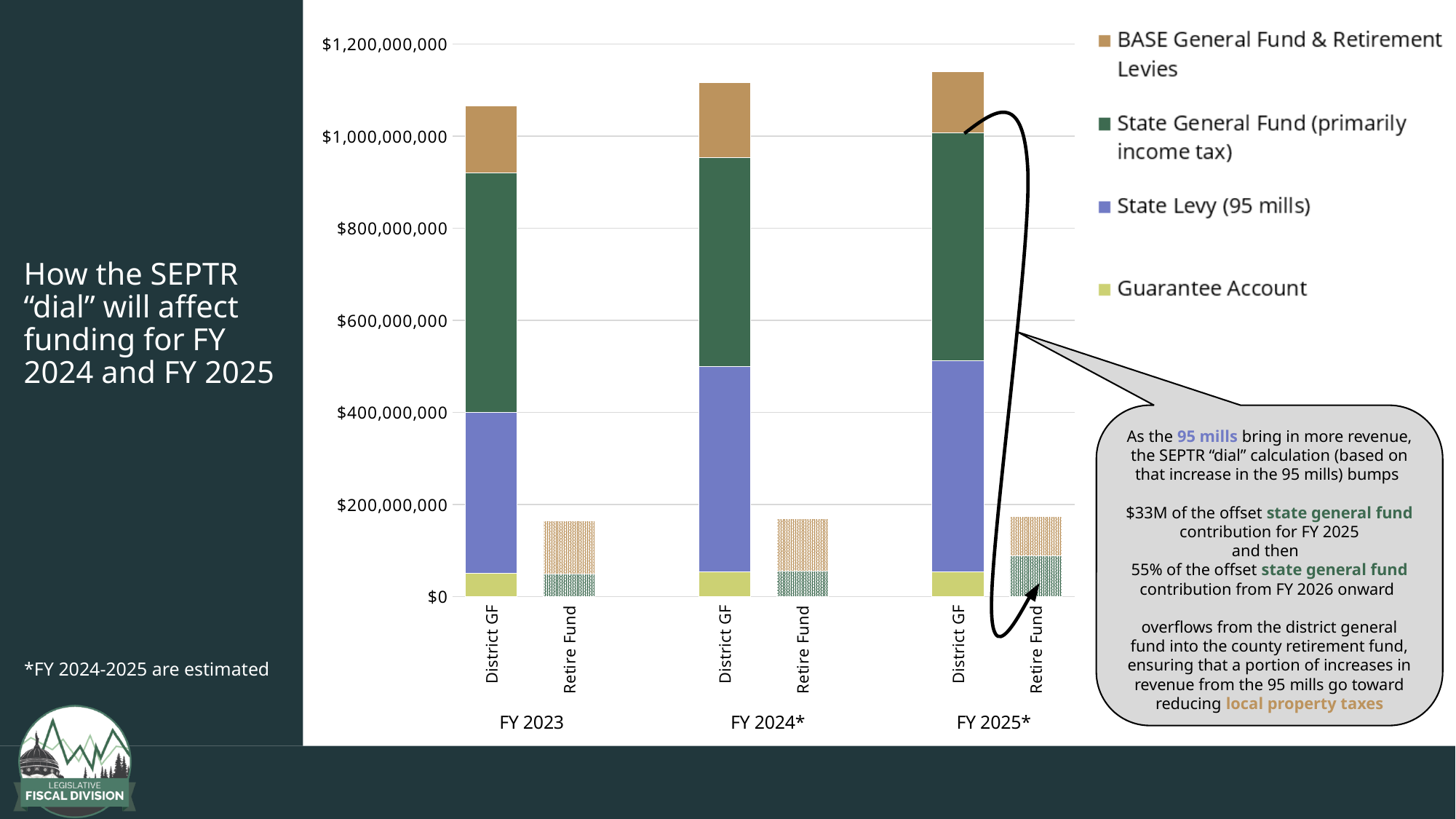
What kind of chart is shown on the slide? Stacked bar chart Do the District GF bar totals rise or fall from FY 2023 to FY 2025*? rise Which legend entry is shown in blue/purple? State Levy (95 mills) How many fiscal years are shown along the x axis of the chart? 3 Which fiscal year has the shortest District GF bar? FY 2023 Is the total value of the District GF bar for FY 2023 greater or less than $1,000,000,000? greater Is the top of the State Levy (95 mills) segment in the District GF bar for FY 2025* greater or less than $400,000,000? greater Is the total value of the Retire Fund bar for FY 2024* greater or less than $200,000,000? less How many bars are plotted in the chart? 6 How many series does the chart legend list? 4 Which fiscal year has the tallest District GF bar? FY 2025* Which is larger, the District GF bar for FY 2025* or the District GF bar for FY 2023? District GF for FY 2025*